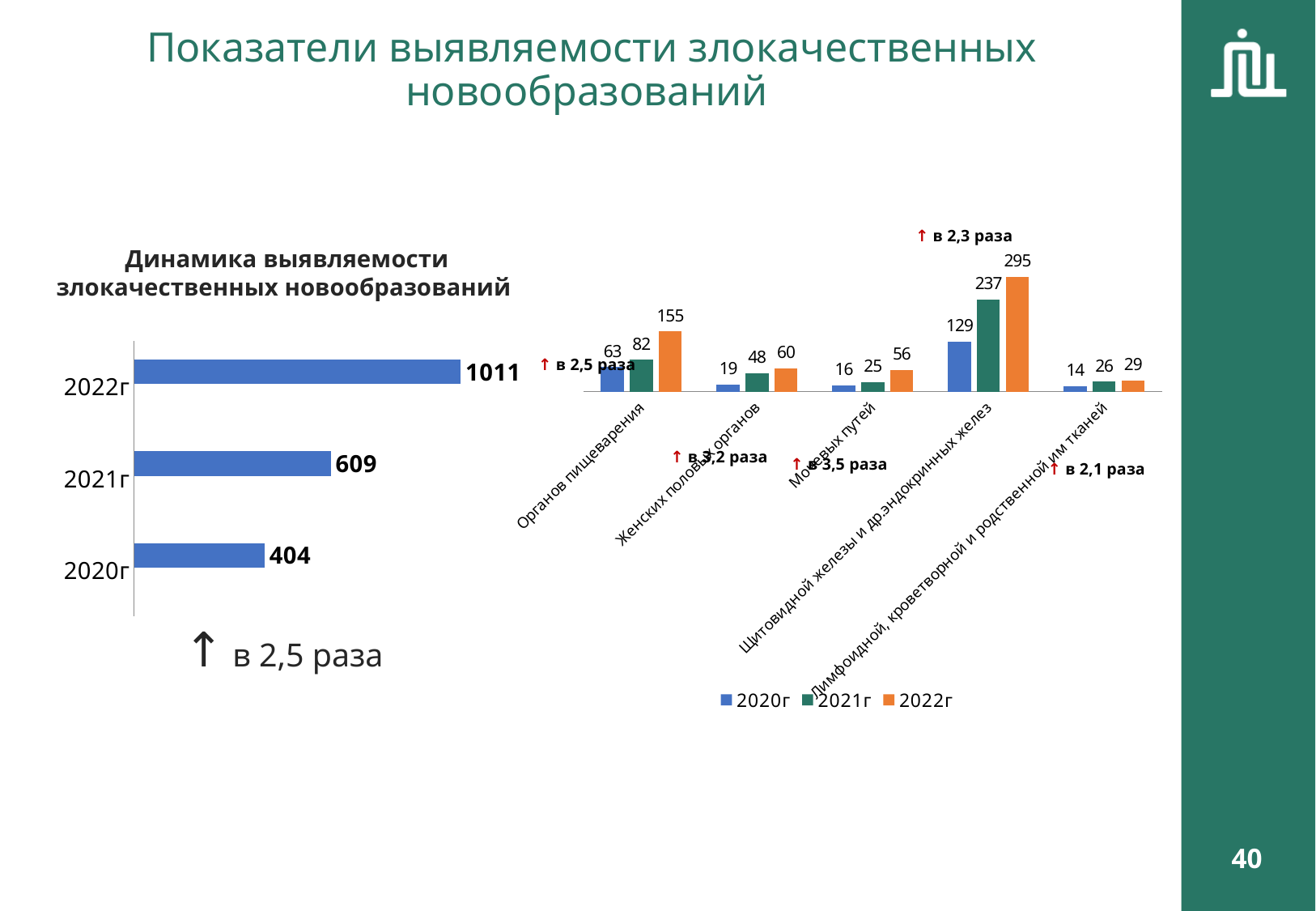
What kind of chart is the left chart 'Динамика выявляемости злокачественных новообразований'? bar chart In the right grouped bar chart, what is the difference between the 2022г and 2020г values for 'Щитовидной железы и др.эндокринных желез'? 166 In the left chart 'Динамика выявляемости злокачественных новообразований', do the values rise or fall from 2020г to 2022г? rise In the right grouped bar chart, what is the 2022г value for 'Органов пищеварения'? 155 In the right grouped bar chart, which category has the highest 2022г value? Щитовидной железы и др.эндокринных желез In the right grouped bar chart, how many series does the legend list? 3 In the left chart 'Динамика выявляемости злокачественных новообразований', what is the value for 2022г? 1011 In the left chart 'Динамика выявляемости злокачественных новообразований', what is the difference between the 2022г and 2021г values? 402 In the right grouped bar chart, which category has the lowest 2020г value? Лимфоидной, кроветворной и родственной им тканей In the right grouped bar chart, what is the 2021г value for 'Щитовидной железы и др.эндокринных желез'? 237 In the right grouped bar chart, how many categories are shown on the x axis? 5 In the left chart 'Динамика выявляемости злокачественных новообразований', what is the value for 2020г? 404